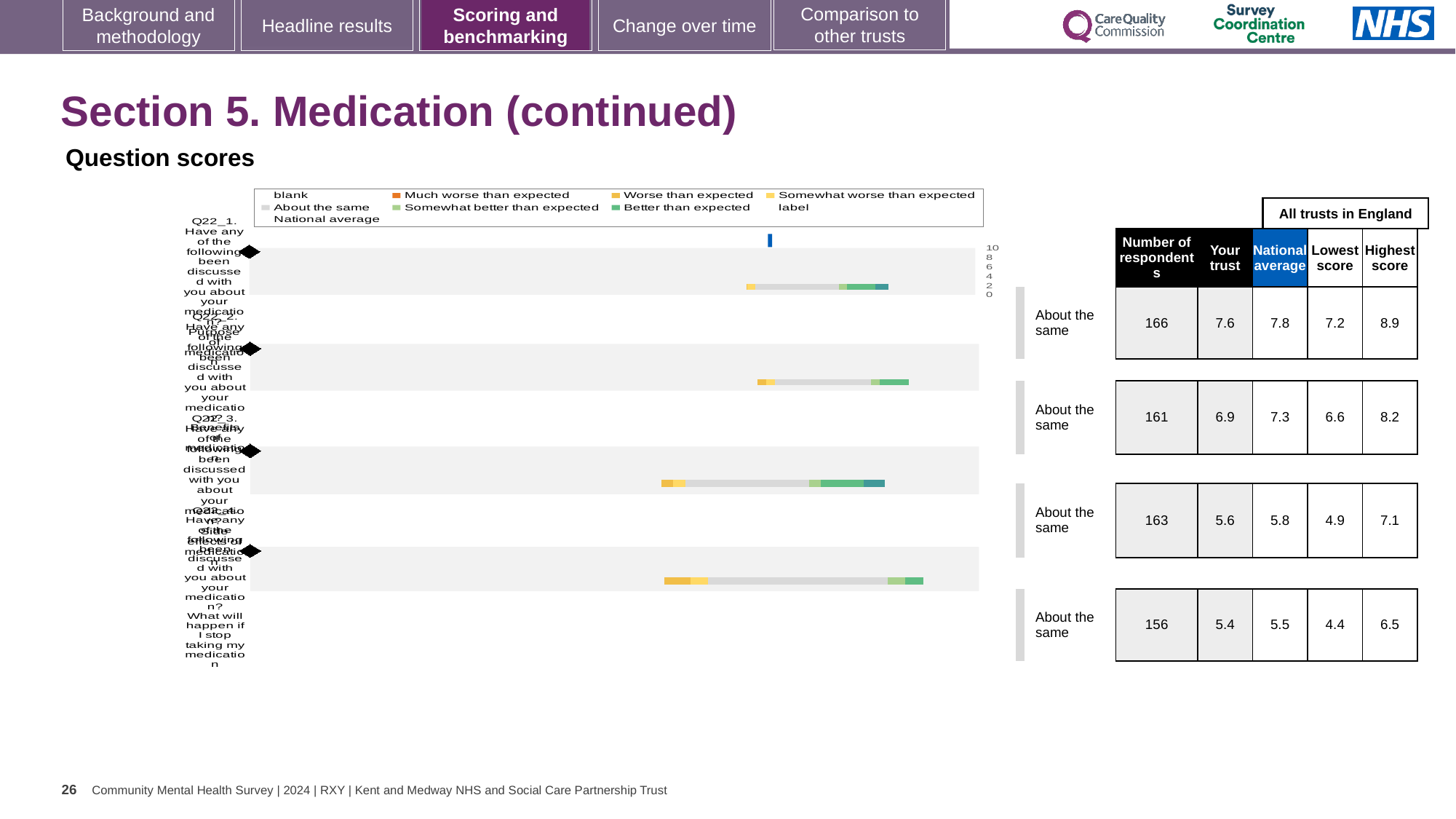
What is the 'Your trust' score for the second question (Q22_2)? 6.9 What is the highest score across all trusts in England for the third question (Q22_3)? 7.1 Which question has the highest 'Your trust' score? Q22_1 (7.6) Which question has the lowest number of respondents? Q22_4 (156) For the first question (Q22_1), which is larger: the 'Your trust' score or the national average? National average What is the number of respondents for the first question (Q22_1)? 166 How many question bars are plotted in the chart? 4 For the second question (Q22_2), what is the difference between the national average and the 'Your trust' score? 0.4 What benchmark category is shown next to each of the four question bars? About the same What kind of chart is shown on the slide? Bar chart Do the 'Your trust' scores rise or fall going down from the first question to the fourth? Fall What colour does the legend use for 'Much worse than expected'? Orange